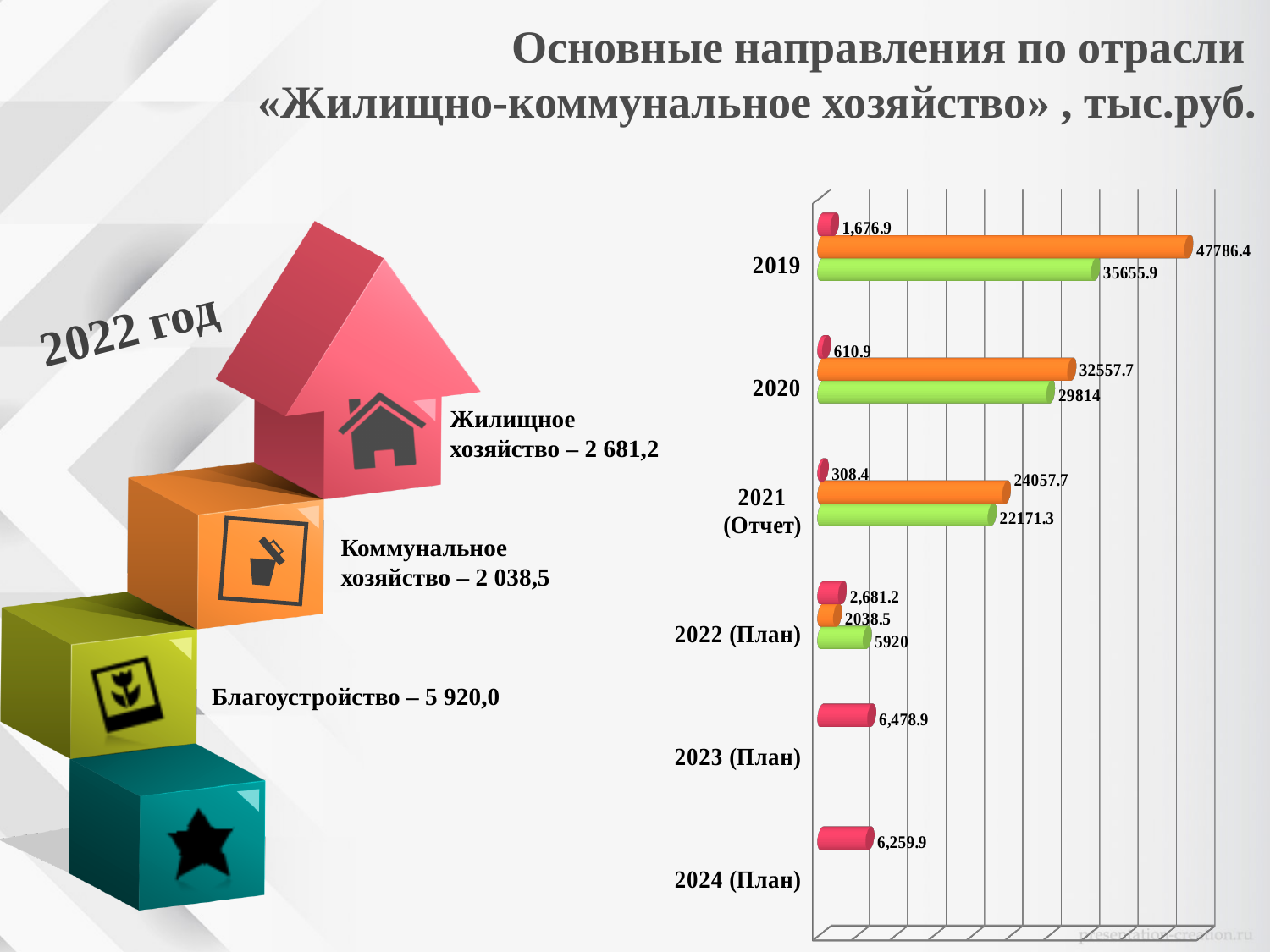
Which category has the highest orange bar? 2019 What kind of chart is shown on the slide? bar chart What is the value of the green bar for 2020? 29814 Do the orange bar values rise or fall from 2019 to 2022 (План)? fall What is the difference between the pink bar for 2023 (План) and the pink bar for 2024 (План)? 219.0 What is the difference between the orange bar and the green bar for 2019? 12130.5 What is the value of the orange bar for 2019? 47786.4 How many categories are shown on the chart's vertical axis? 6 What is the value of the pink bar for 2021 (Отчет)? 308.4 For 2022 (План), which is larger: the pink bar or the orange bar? the pink bar What is the value of the pink bar for 2023 (План)? 6,478.9 Which category has the lowest pink bar? 2021 (Отчет)